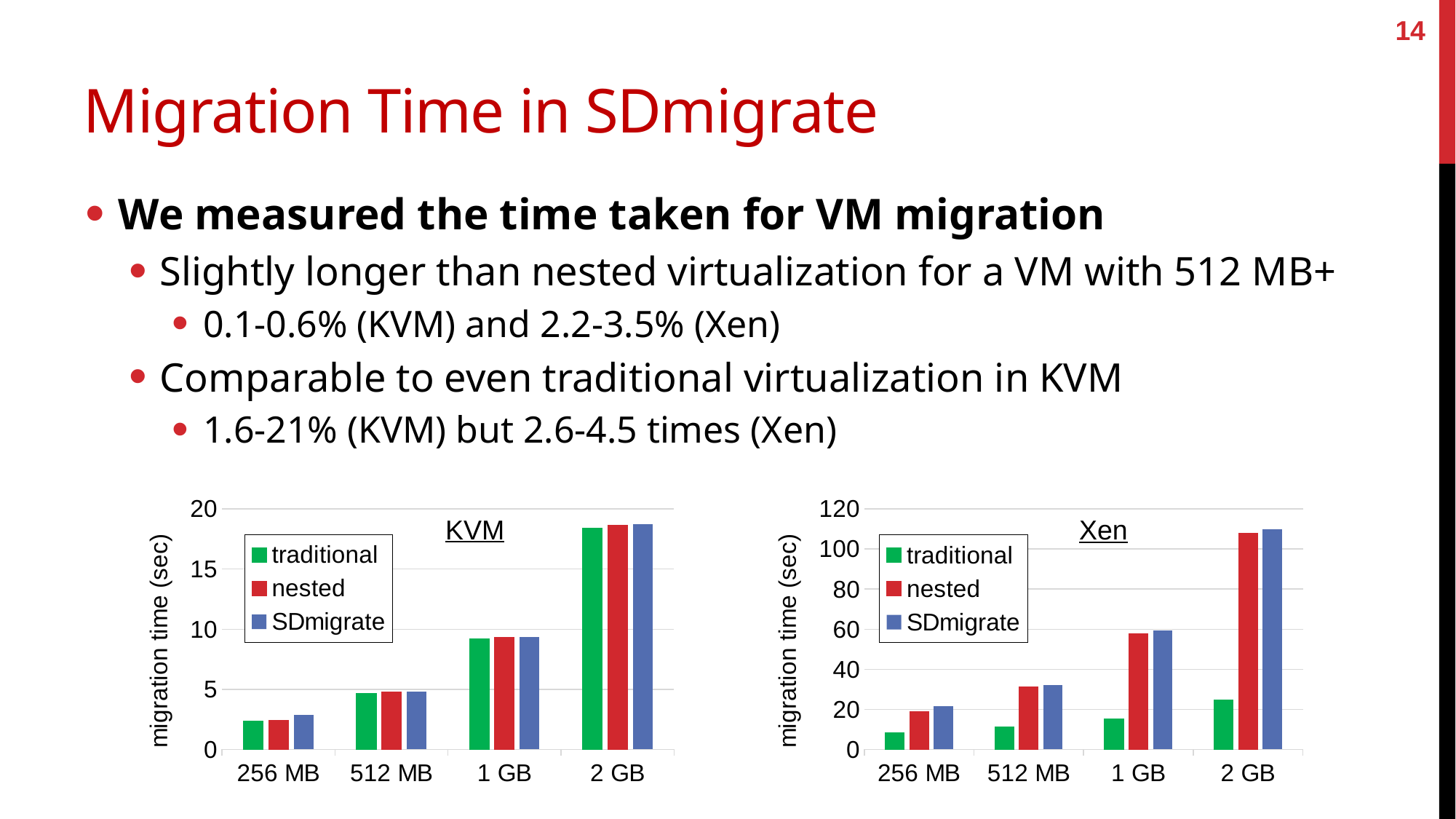
In the KVM chart, what type of chart is shown? bar chart In the Xen chart, how many series does the legend list? 3 In the KVM chart, how many memory-size categories are shown on the x axis? 4 In the KVM chart, is the SDmigrate value for 256 MB greater or less than 5? less In the Xen chart, do the SDmigrate values rise or fall as memory size increases along the x axis? rise In the Xen chart, which category has the highest SDmigrate migration time? 2 GB In the KVM chart, what is the label on the y axis? migration time (sec) In the Xen chart, is the nested value for 2 GB greater or less than 100? greater In the KVM chart, is the traditional value for 2 GB greater or less than 15? greater In the Xen chart, at 2 GB, which is larger: the nested value or the traditional value? nested In the KVM chart, which category has the lowest traditional migration time? 256 MB